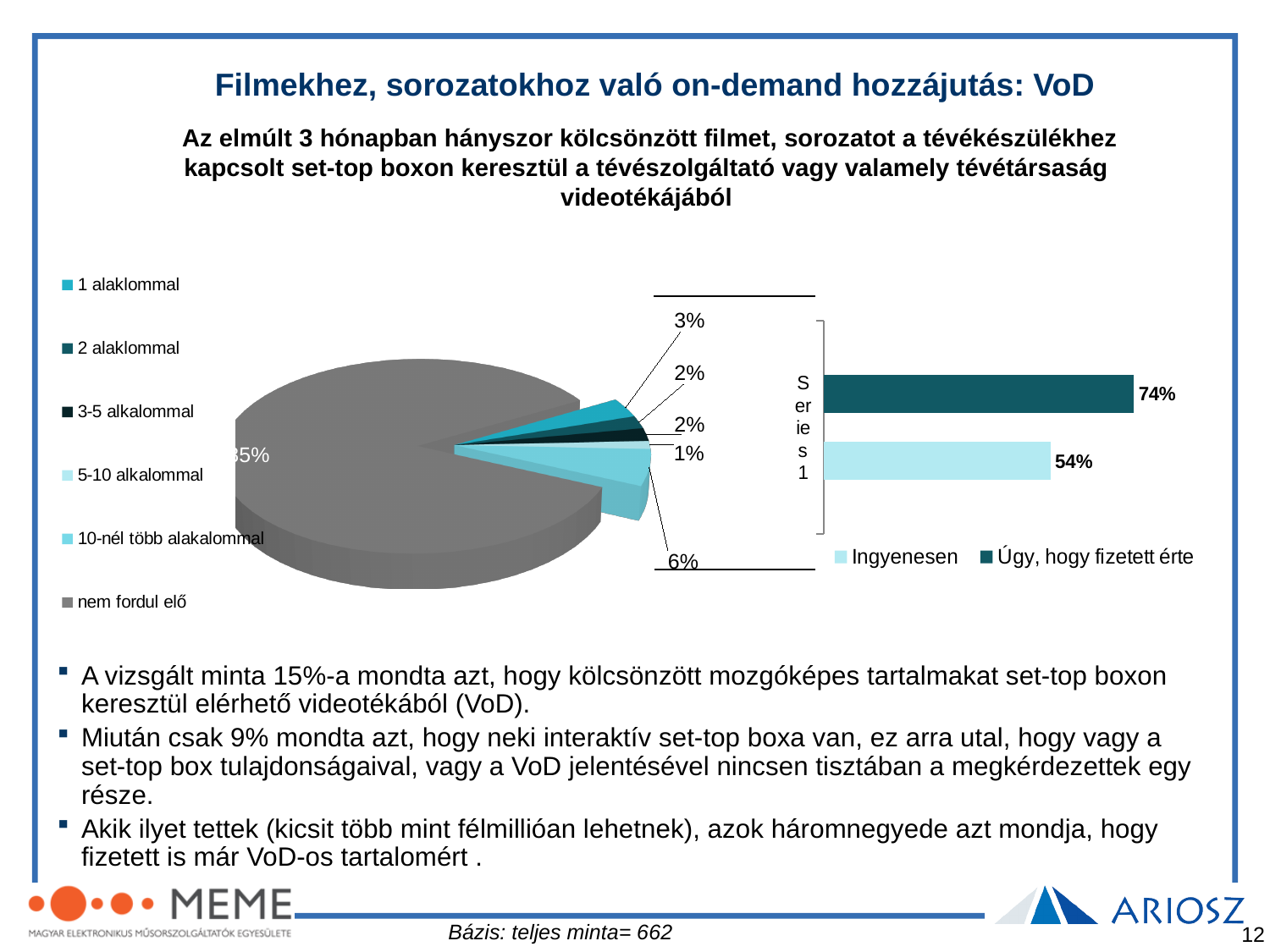
In the bar chart on the right, what is the difference between 'Úgy, hogy fizetett érte' and 'Ingyenesen'? 20 percentage points What kind of chart is the chart on the left of the slide? pie chart What kind of chart is the chart on the right of the slide? bar chart How many series does the legend of the bar chart on the right list? 2 In the pie chart on the left, what is the smallest percentage label shown? 1% In the bar chart on the right, which legend entry is shown in light blue? Ingyenesen In the bar chart on the right, what is the value for 'Úgy, hogy fizetett érte'? 74% In the bar chart on the right, what is the value for 'Ingyenesen'? 54% In the bar chart on the right, which is larger: 'Ingyenesen' or 'Úgy, hogy fizetett érte'? Úgy, hogy fizetett érte How many categories does the legend of the pie chart on the left list? 6 In the pie chart on the left, which category has the largest slice? nem fordul elő What is the base (Bázis) sample size stated at the bottom of the slide? 662